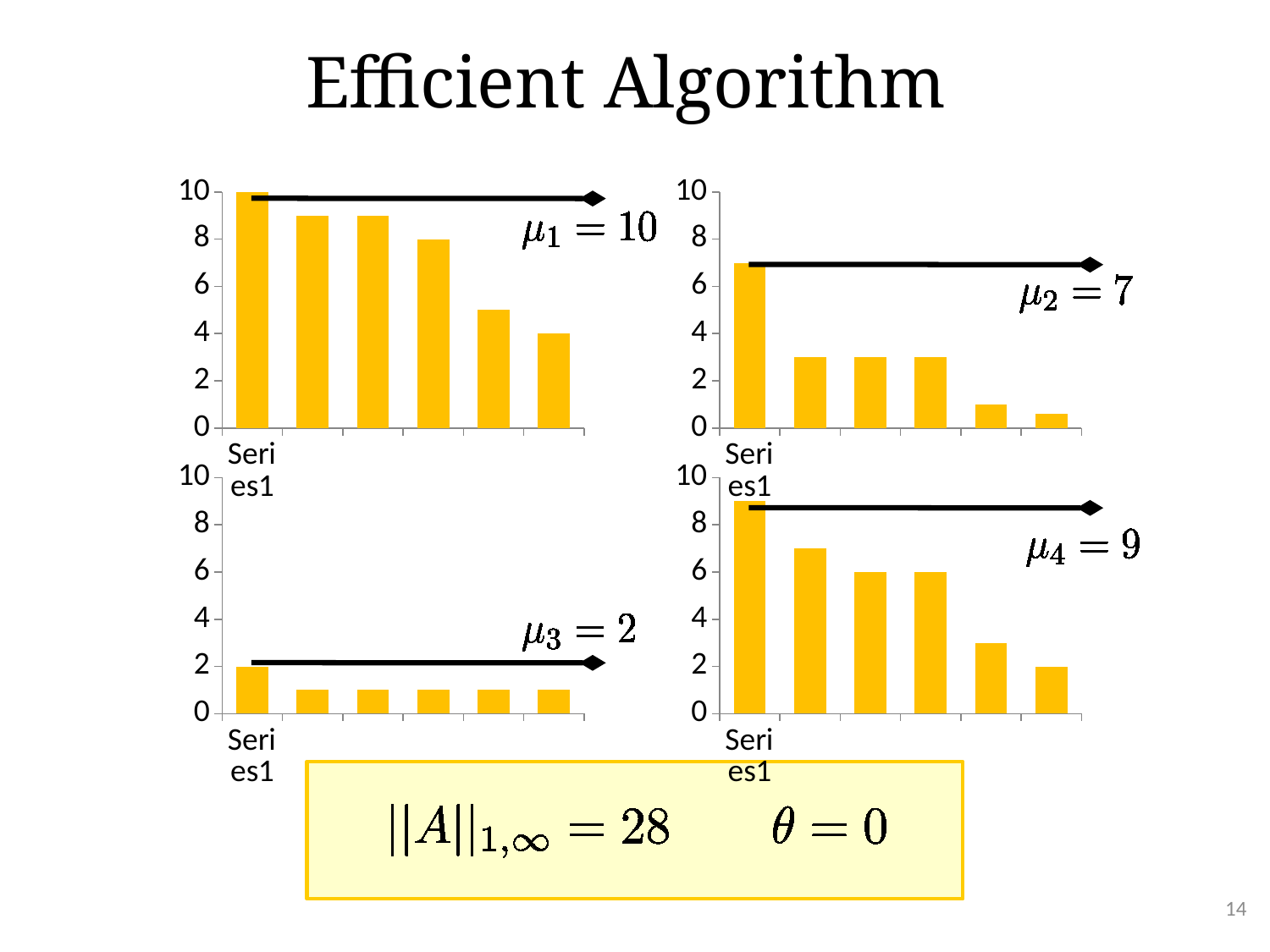
In the top-left chart, what is the value of the last (sixth) bar? 4 What is the legend entry shown under the bottom-right chart? Series1 In the top-left chart, which bar is the tallest? the first bar In the top-left chart, do the bar values rise or fall from left to right? fall In the bottom-left chart, what is the value of the first bar? 2 What kind of chart is the top-left chart on the slide? bar chart How many series does the legend of the bottom-left chart list? 1 How many bars does the top-right chart have? 6 In the bottom-right chart, is the first bar taller than the second bar? yes In the top-left chart, what is the value of the first bar? 10 In the top-right chart, is the value of the first bar greater or less than 6? greater In the top-right chart, is the value of the second bar greater or less than 4? less